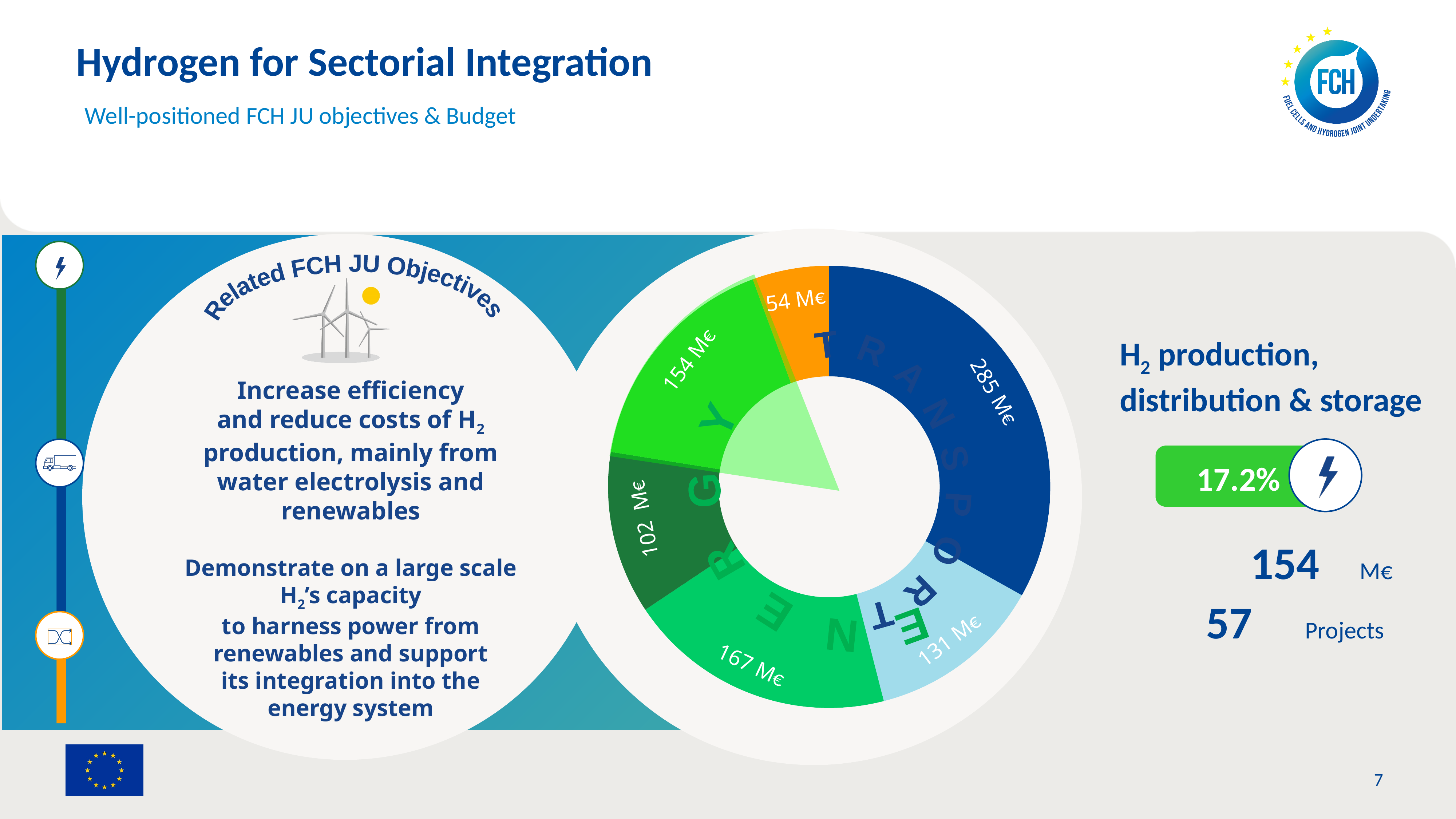
What is the total of all six segment values on the donut chart? 893 M€ What is the difference between the largest segment (285 M€) and the light blue segment (131 M€) on the donut chart? 154 M€ How many projects are listed next to the donut chart for H2 production, distribution & storage? 57 What is the largest value shown on the donut chart? 285 M€ What value is shown on the orange segment of the donut chart? 54 M€ What share of the budget does the H2 production, distribution & storage segment represent, according to the slide? 17.2% How many segments does the donut chart have? 6 What value is shown on the highlighted (bright green) segment of the donut chart that corresponds to H2 production, distribution & storage? 154 M€ Which is larger on the donut chart: the 167 M€ segment or the 131 M€ segment? 167 M€ What kind of chart is shown in the centre of the slide? Donut (pie) chart What value is shown on the dark blue segment of the donut chart? 285 M€ What is the smallest value shown on the donut chart? 54 M€